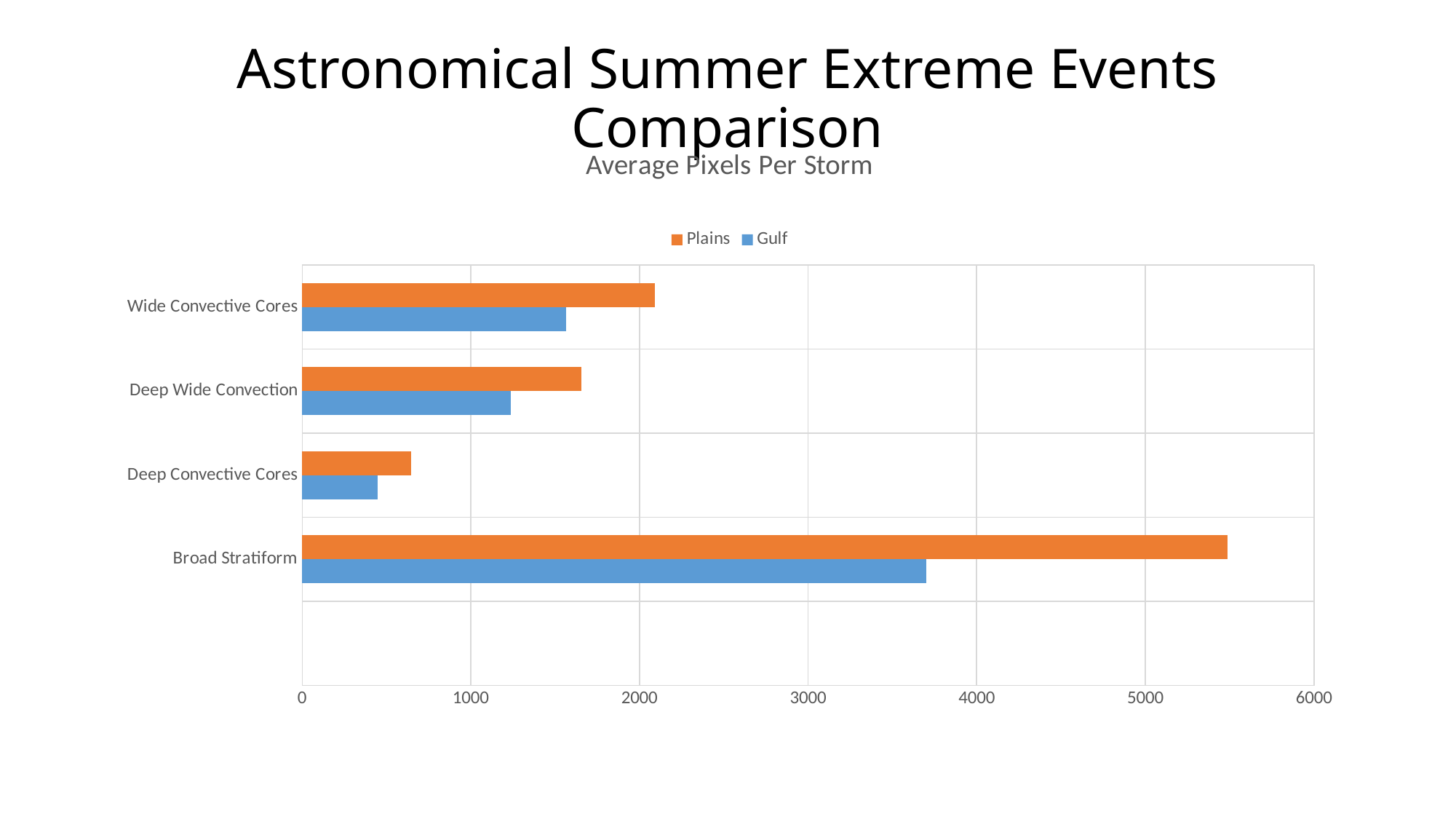
Which category has the highest Plains value? Broad Stratiform What kind of chart is shown on the slide? bar chart Is the Plains value for Deep Wide Convection greater or less than 2000? less Is the Gulf value for Broad Stratiform greater or less than 4000? less For Broad Stratiform, which series has the larger value, Plains or Gulf? Plains What is the title of the chart? Average Pixels Per Storm Which category has the lowest Gulf value? Deep Convective Cores Is the Plains value for Broad Stratiform greater or less than 5000? greater How many categories are shown on the chart? 4 How many series does the legend list? 2 Which colour represents the Gulf series in the legend? blue